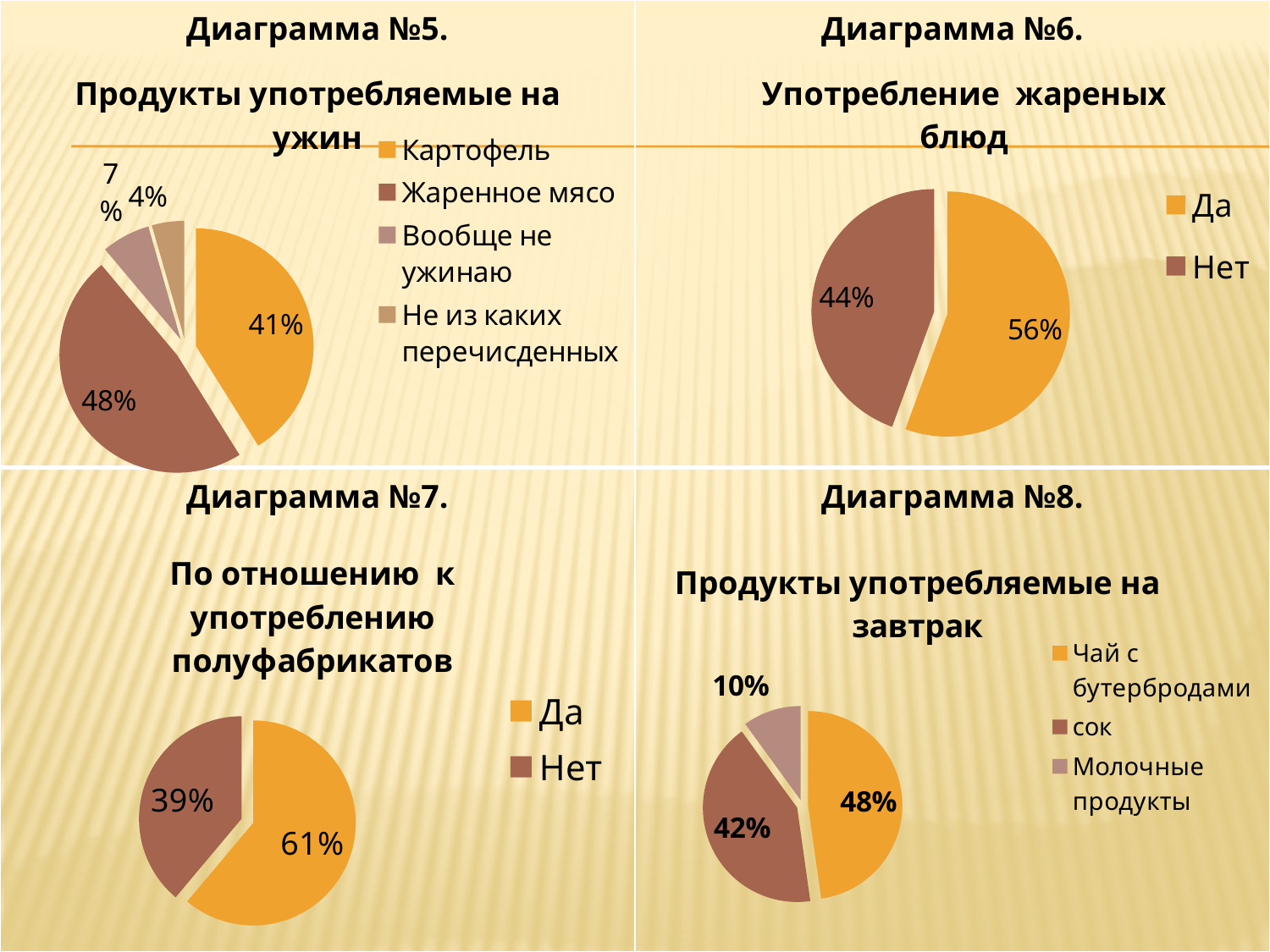
In Диаграмма №5 (Продукты употребляемые на ужин), which category has the largest slice? Жаренное мясо In Диаграмма №6 (Употребление жареных блюд), what share answered Да? 56% In Диаграмма №7 (По отношению к употреблению полуфабрикатов), which is larger, Да or Нет? Да In Диаграмма №8 (Продукты употребляемые на завтрак), what share is shown for сок? 42% In Диаграмма №5 (Продукты употребляемые на ужин), how many categories does the legend list? 4 In Диаграмма №6 (Употребление жареных блюд), what is the difference between Да and Нет? 12% In Диаграмма №5 (Продукты употребляемые на ужин), what share is shown for Картофель? 41% In Диаграмма №5 (Продукты употребляемые на ужин), which category has the smallest slice? Не из каких перечисденных In Диаграмма №8 (Продукты употребляемые на завтрак), what is the difference between Чай с бутербродами and Молочные продукты? 38% What type of chart is Диаграмма №8 (Продукты употребляемые на завтрак)? Pie chart In Диаграмма №7 (По отношению к употреблению полуфабрикатов), what share answered Нет? 39% How many charts are shown on the slide? 4